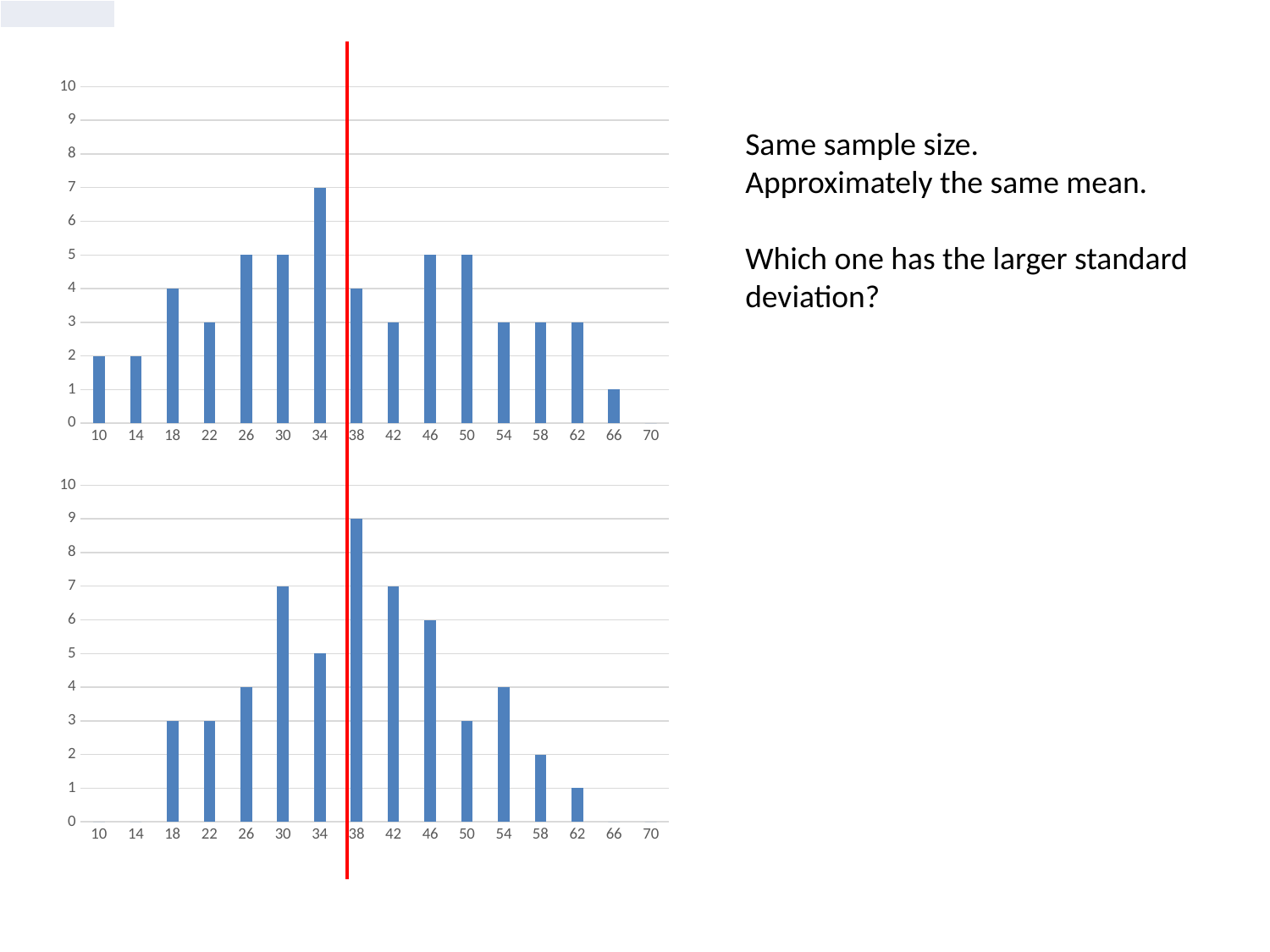
In the top chart, what is the value for category 66? 1 In the bottom chart, what is the value for category 38? 9 In the bottom chart, what is the difference between the values for categories 38 and 62? 8 In the bottom chart, which category has the highest bar? 38 In the top chart, what is the value for category 34? 7 How many category labels are shown on the x axis of the top chart? 16 In the top chart, which category has the highest bar? 34 What kind of chart is the bottom chart? bar chart In the bottom chart, what is the value for category 30? 7 What colour is the vertical line drawn across both charts? red In the top chart, which is larger, the value for category 18 or the value for category 22? 18 In the bottom chart, is the value for category 42 greater or less than 5? greater